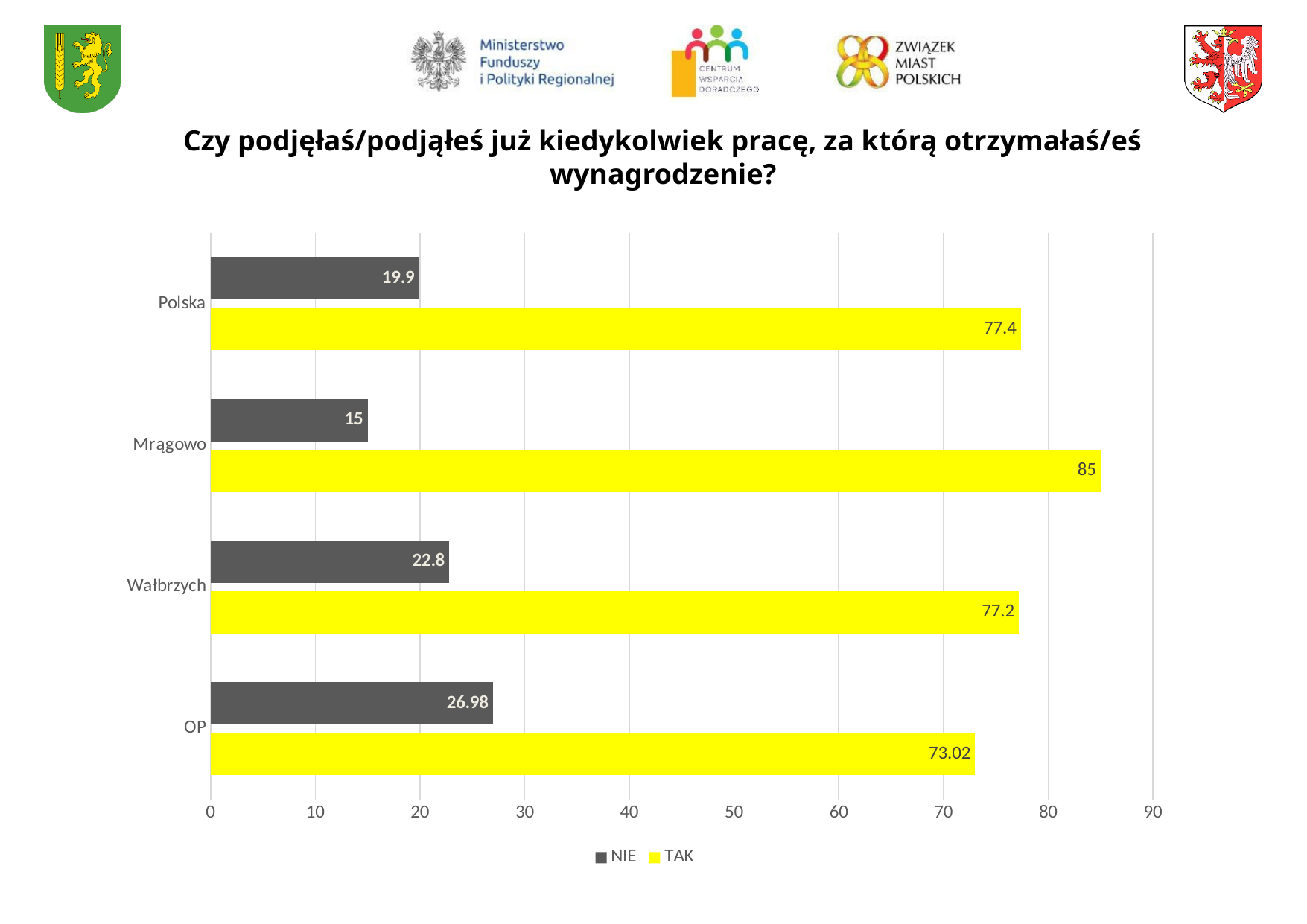
What is the NIE value for OP? 26.98 How many series does the legend list? 2 Which category has the lowest NIE value? Mrągowo What is the difference between the TAK values for Mrągowo and OP? 11.98 Which category has the highest TAK value? Mrągowo How many categories are shown on the y axis? 4 Which is larger, the NIE value for OP or the NIE value for Polska? OP What is the difference between the TAK and NIE values for Wałbrzych? 54.4 What kind of chart is shown on the slide? Bar chart What is the TAK value for Mrągowo? 85 Which colour represents the TAK series? Yellow What is the TAK value for Polska? 77.4